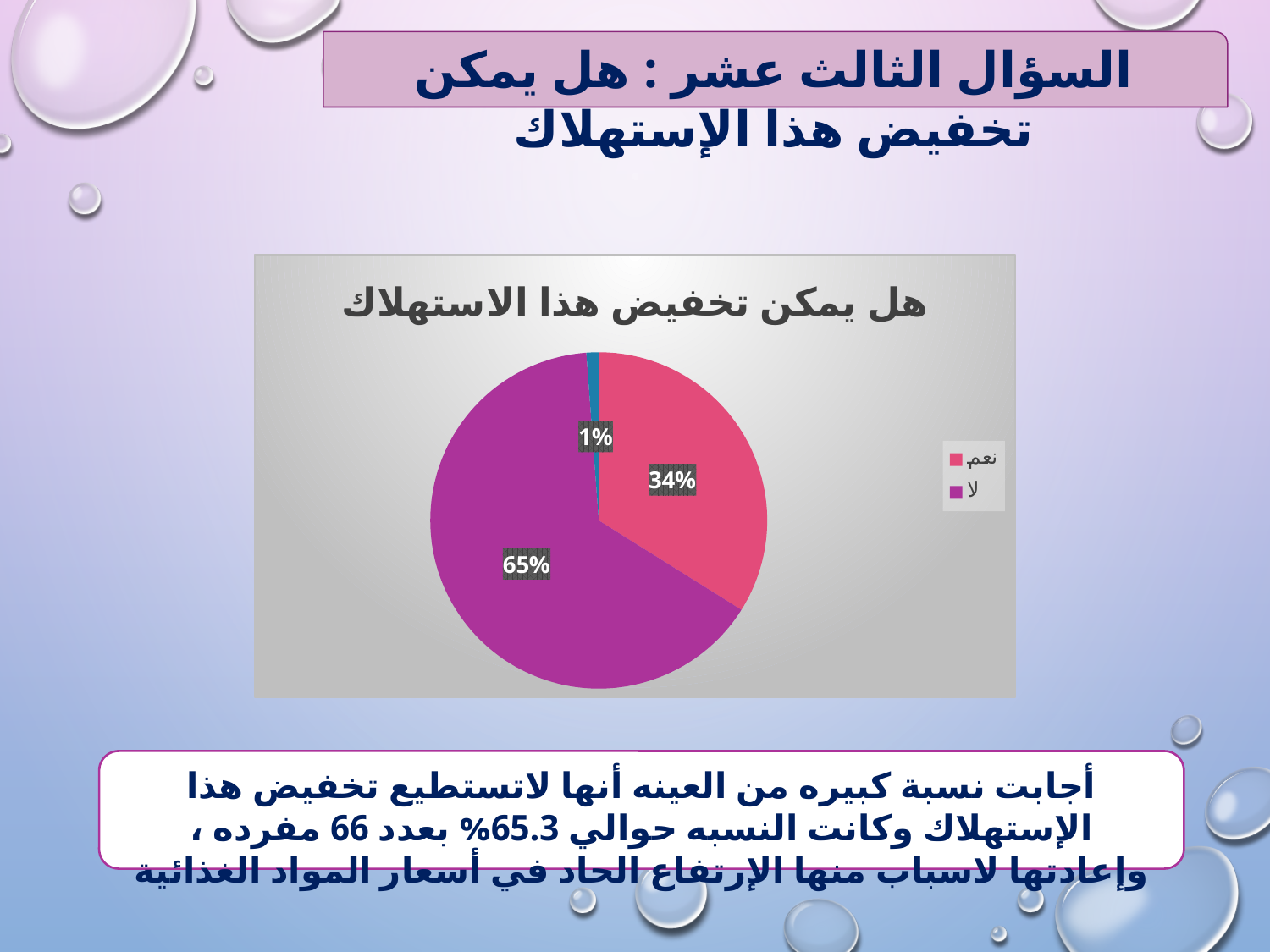
What percentage is shown on the small blue slice of the pie? 1% What is the title of the chart? هل يمكن تخفيض هذا الاستهلاك What type of chart is shown on the slide? pie chart What percentage of the pie is labelled for the category لا? 65% What is the difference in percentage points between the لا slice and the نعم slice? 31 What colour is the slice for نعم in the pie chart? pink How many entries does the legend list? 2 Which is larger, the slice for نعم or the slice for لا? لا How many slices does the pie chart have? 3 What percentage of the pie is labelled for the category نعم? 34% Which slice of the pie is the smallest? the blue slice (1%) Which category has the largest slice of the pie? لا